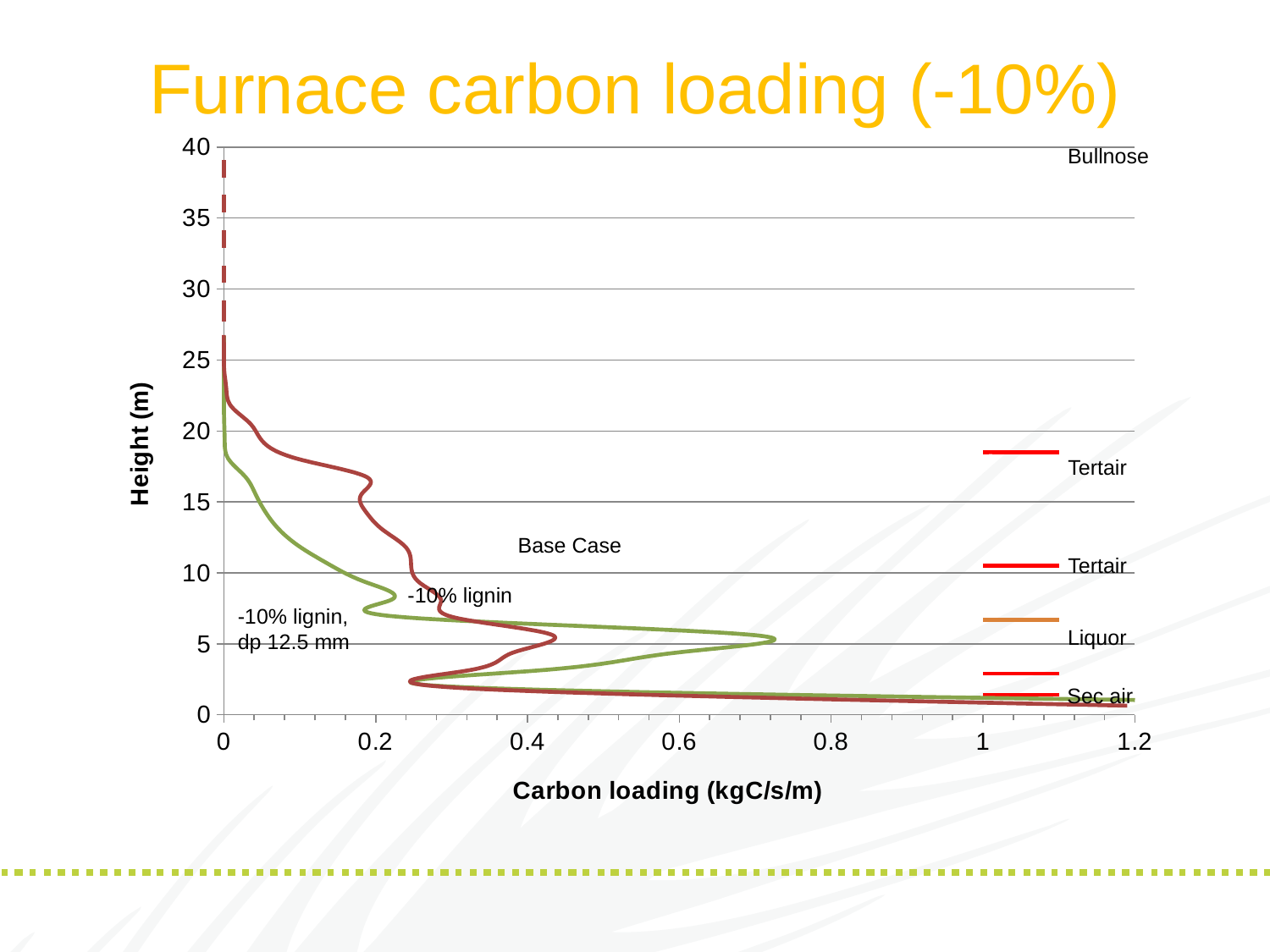
Is the peak carbon loading of the -10% lignin curve near 5 m height greater or less than 0.6? greater What is the label of the horizontal axis? Carbon loading (kgC/s/m) At a height of 15 m, which curve shows the higher carbon loading, Base Case or -10% lignin? Base Case How many curves are plotted on the chart? 2 Is the carbon loading of the Base Case curve at a height of 15 m greater or less than 0.4? less Do the carbon loading values of both curves generally rise or fall as height increases above 5 m? fall Is the carbon loading of the -10% lignin curve at a height of 15 m greater or less than 0.2? less What is the maximum value shown on the vertical (Height) axis? 40 What kind of chart is shown on the slide? line chart At a height of 5 m, which curve shows the higher carbon loading, Base Case or -10% lignin? -10% lignin What is the title of the chart? Furnace carbon loading (-10%)